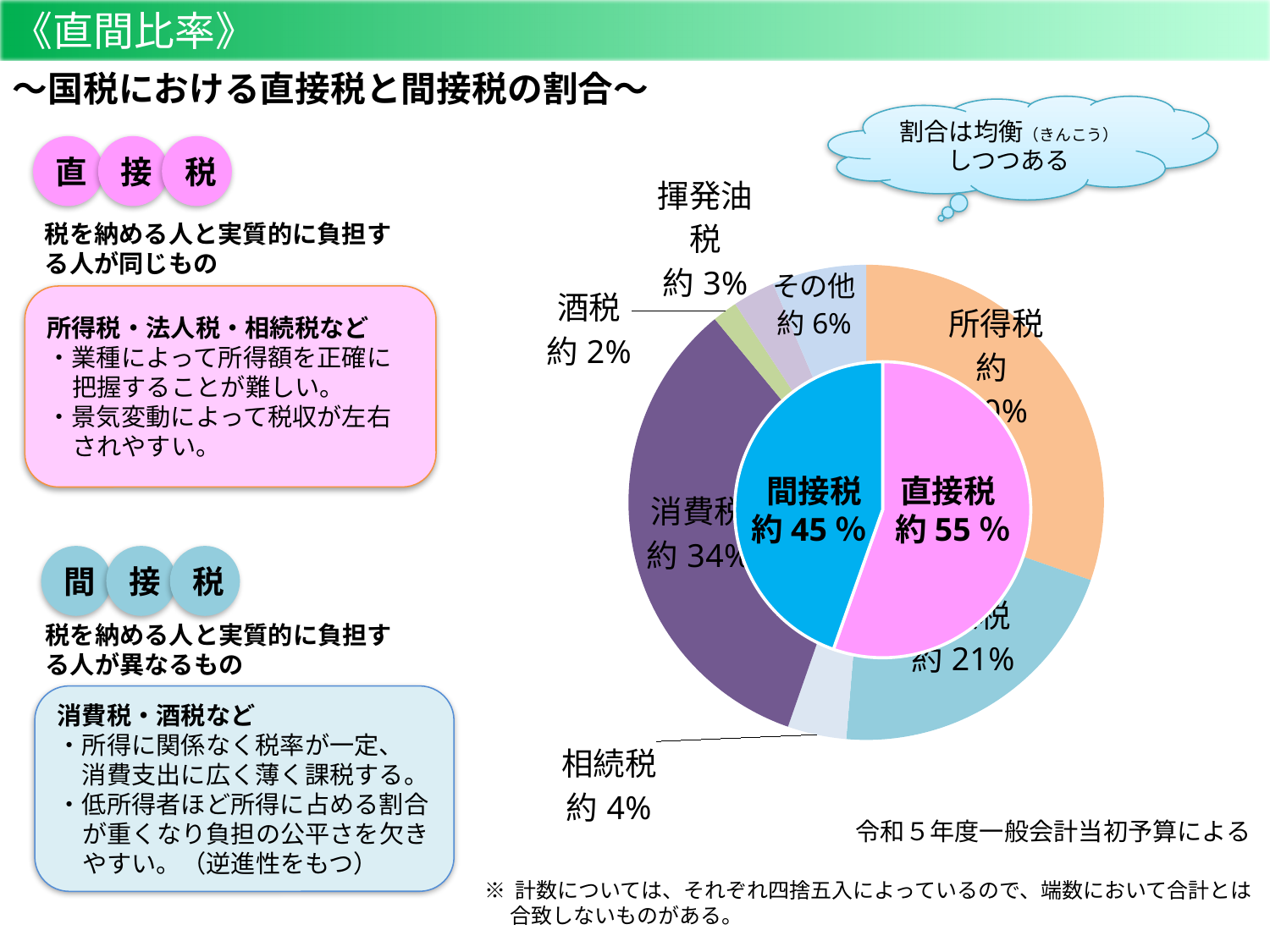
What share is shown for 揮発油税? 約 3% What share does the inner ring show for 間接税? 約 45 % What share is shown for 酒税? 約 2% What share is shown for その他? 約 6% Which labelled tax in the outer ring has the smallest share? 酒税 What share is shown for 消費税 in the outer ring? 約 34% By how many percentage points does 直接税 exceed 間接税 in the inner ring? 10 Which is larger, 消費税 or 相続税? 消費税 What share does the inner ring show for 直接税? 約 55 % What kind of chart is shown on the slide? Doughnut chart What share is shown for 相続税? 約 4% Which is larger in the inner ring, 直接税 or 間接税? 直接税